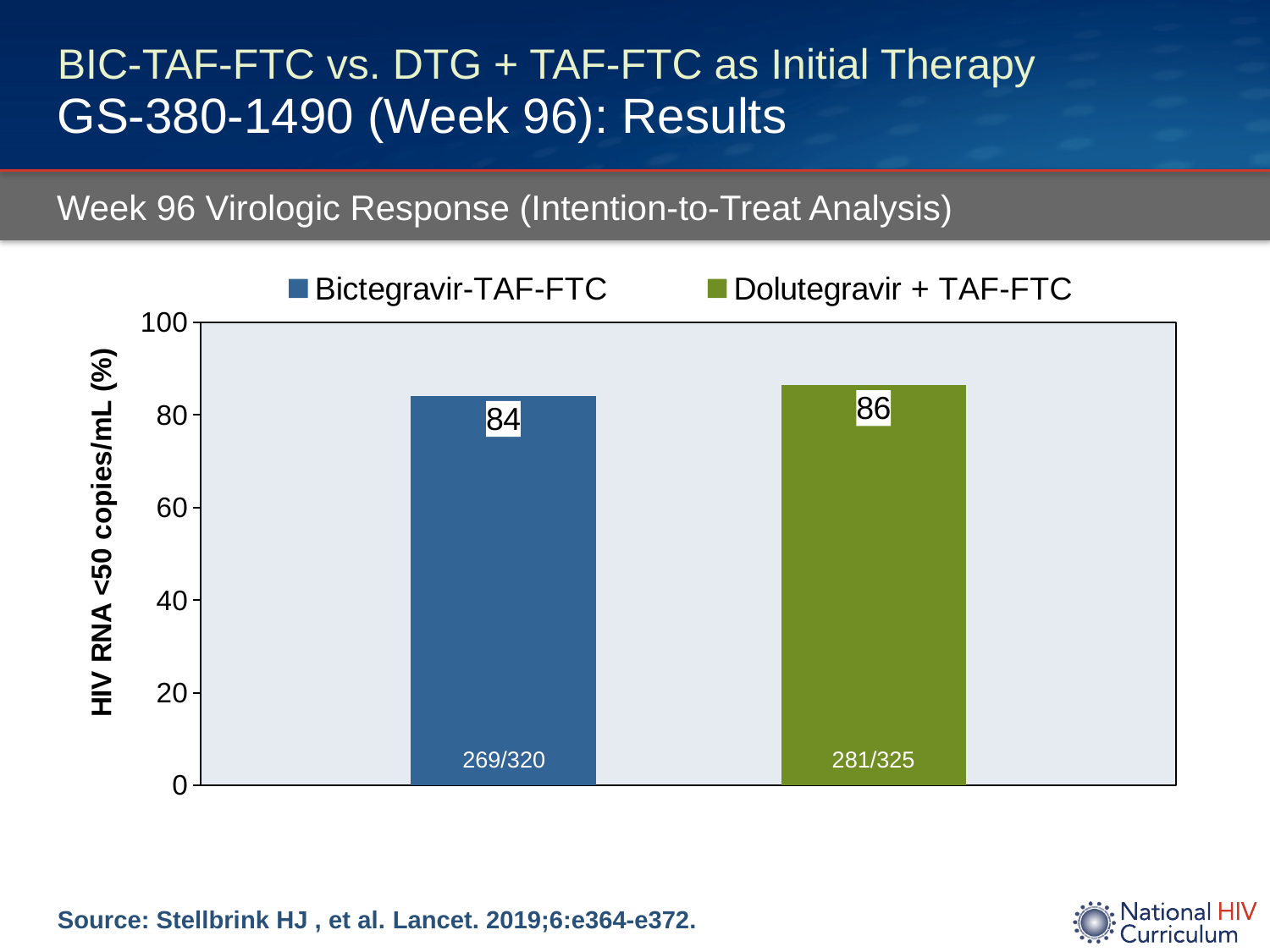
What fraction is printed inside the Bictegravir-TAF-FTC bar? 269/320 What is the value for Bictegravir-TAF-FTC? 84 What is the value for Dolutegravir + TAF-FTC? 86 What is the difference between the Dolutegravir + TAF-FTC value and the Bictegravir-TAF-FTC value? 2 What fraction is printed inside the Dolutegravir + TAF-FTC bar? 281/325 How many series does the legend list? 2 What kind of chart is shown? bar chart What colour is the Dolutegravir + TAF-FTC bar? green Which series has the lower value? Bictegravir-TAF-FTC Which series has the higher value? Dolutegravir + TAF-FTC Is the value for Bictegravir-TAF-FTC greater or less than 80? greater What is the y-axis label of the chart? HIV RNA <50 copies/mL (%)